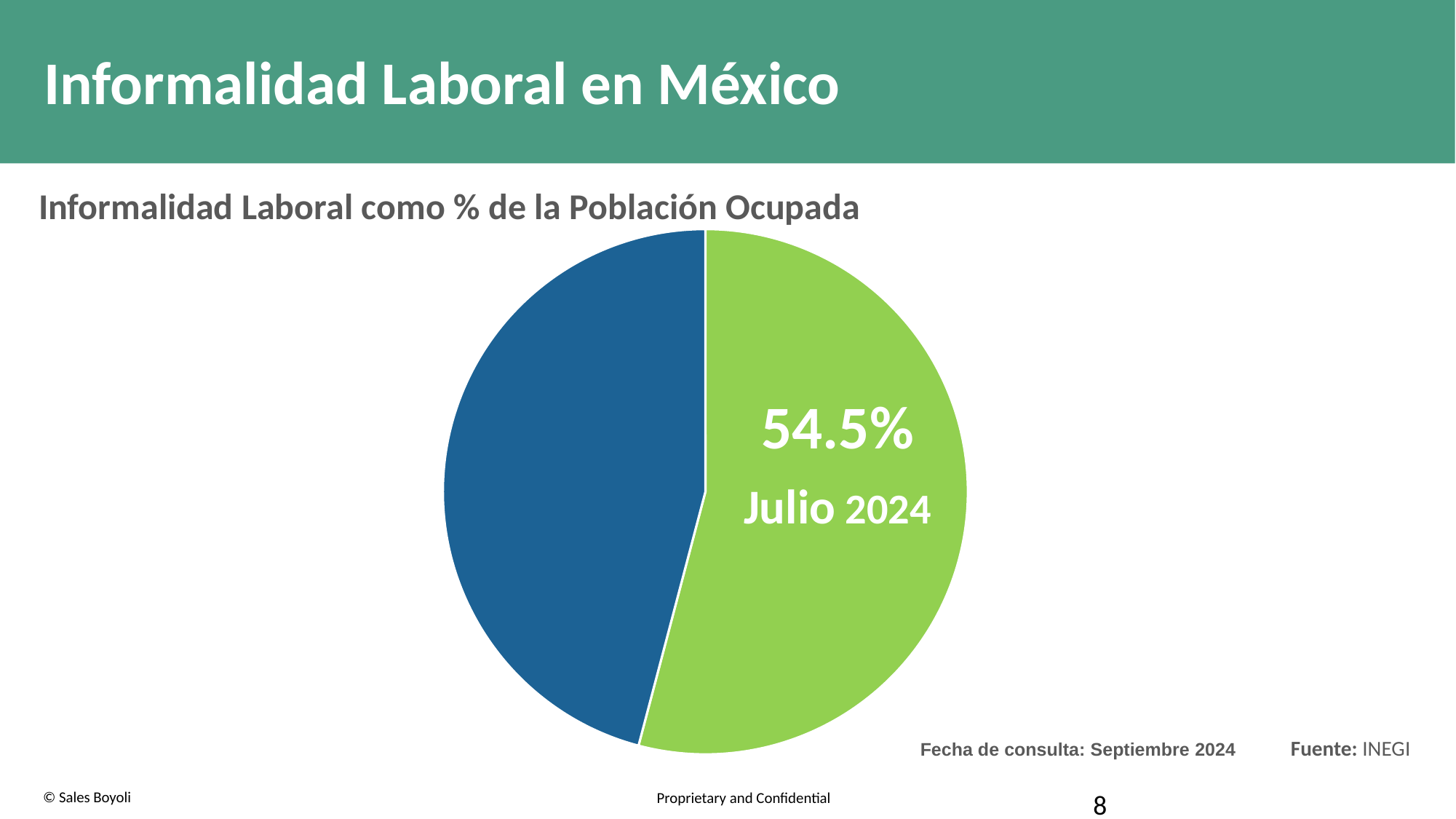
What is the title of the chart on the slide? Informalidad Laboral como % de la Población Ocupada What value is printed on the green slice of the pie chart? 54.5% How many slices does the pie chart have? 2 Which slice of the pie chart is larger, the green one or the blue one? The green one What colour is the slice of the pie chart that carries the 54.5% label? Green Is the share of the green slice in the pie chart greater or less than 50%? greater Which month and year does the 54.5% value in the pie chart refer to? Julio 2024 What kind of chart is shown on the slide? Pie chart